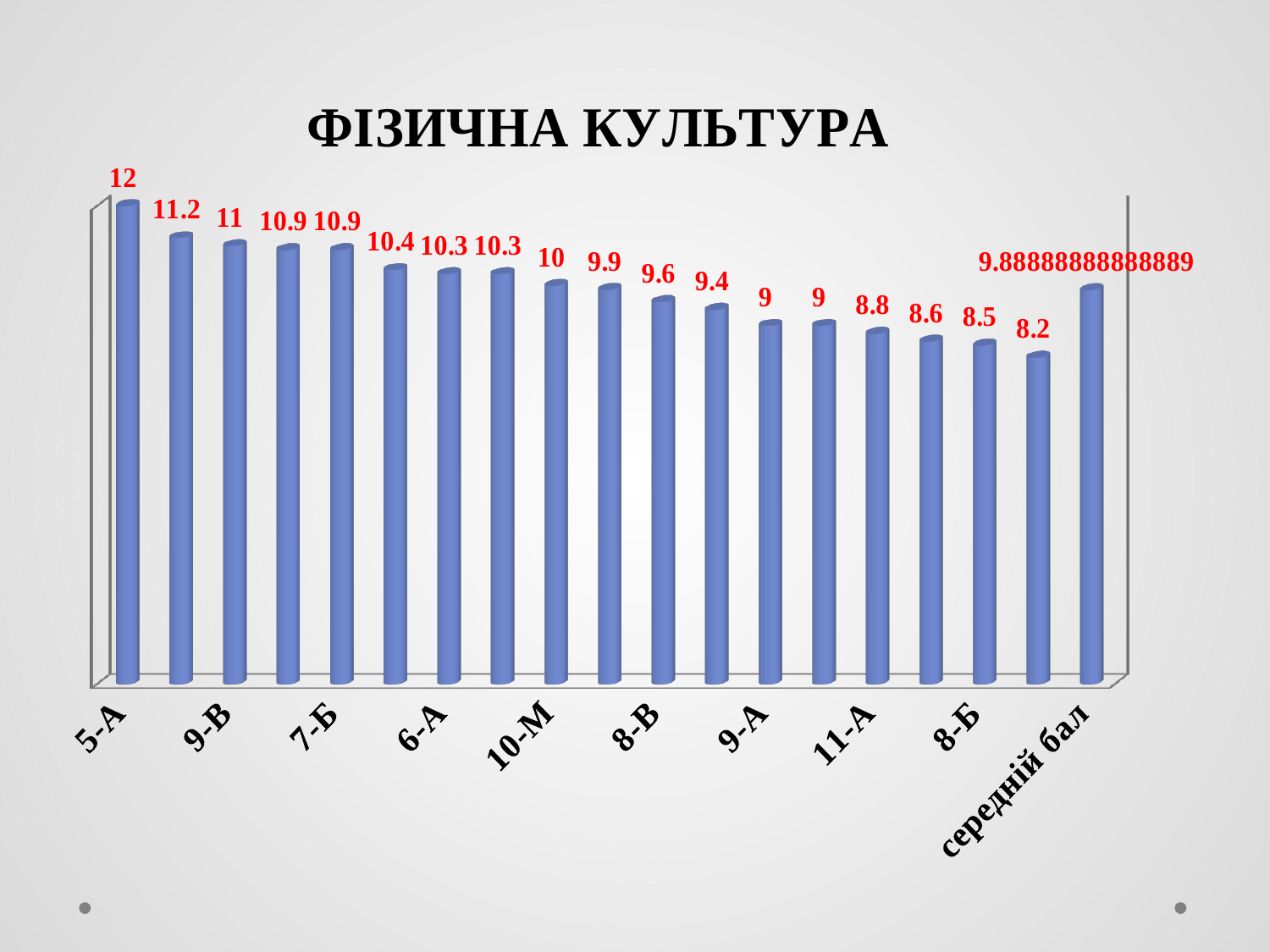
What is the title of the chart? ФІЗИЧНА КУЛЬТУРА How many bars are plotted on the chart? 19 Which is larger, the value for 7-Б or the value for 6-А? 7-Б What is the value for 9-В? 11 What is the difference between the values for 5-А and 9-В? 1 What is the value labelled for середній бал? 9.88888888888889 What kind of chart is shown? Bar chart What is the value for 8-Б? 8.5 What is the value for 5-А? 12 What is the lowest value shown on the chart? 8.2 Which category has the highest value? 5-А What is the value for 10-М? 10